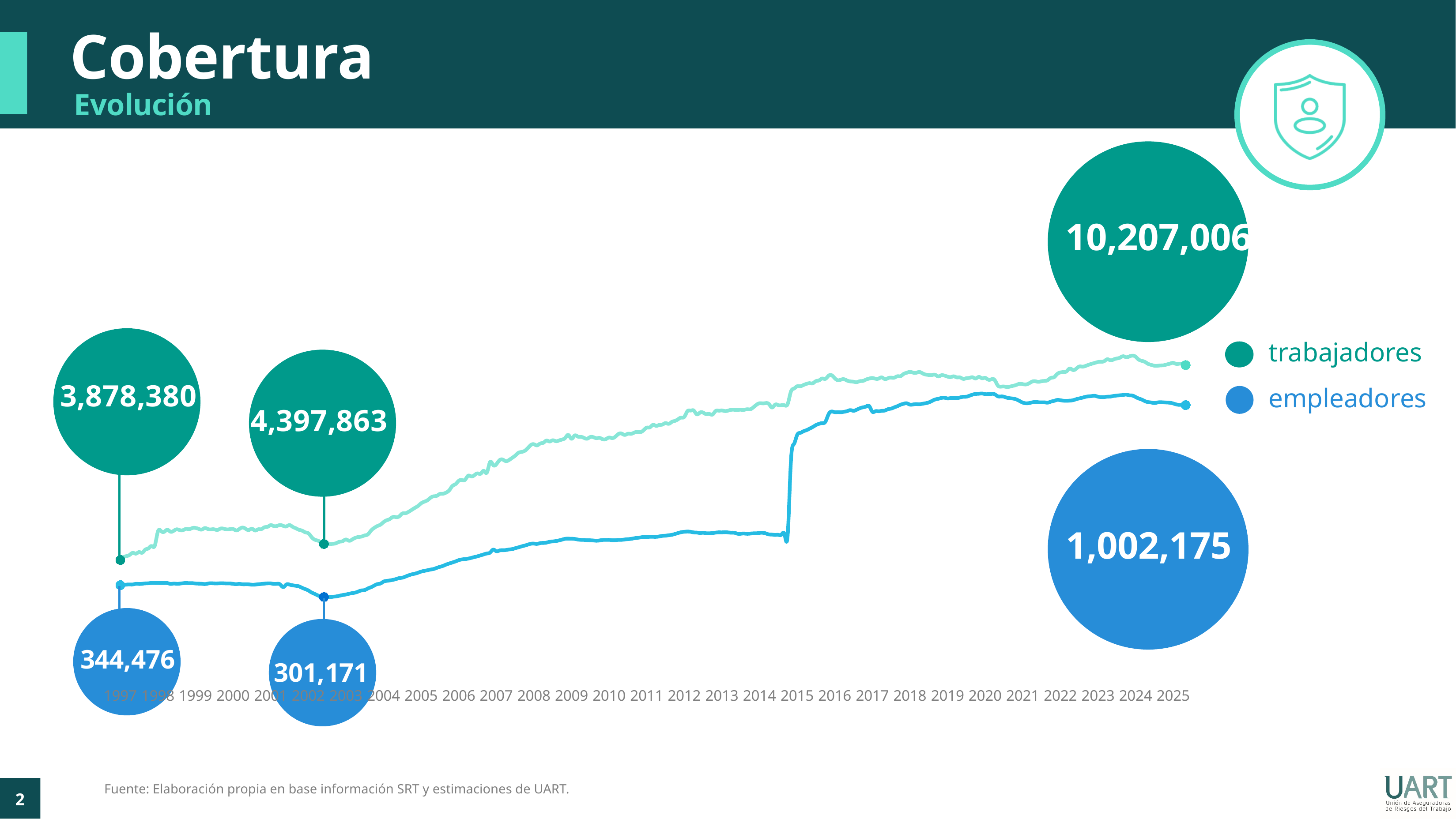
Does the trabajadores line generally rise or fall from 1997 to 2025? rise What is the value for empleadores in 2025? 1,002,175 What is the value for trabajadores in 2025? 10,207,006 What is the value for trabajadores in 1997? 3,878,380 How many series does the legend list? 2 What type of chart is shown on the slide? line chart What is the value for trabajadores in 2002? 4,397,863 What is the value for empleadores in 2002? 301,171 What is the difference between the empleadores value in 1997 and in 2002? 43,305 Which series has the higher value in 2025, trabajadores or empleadores? trabajadores What is the difference between the trabajadores value in 2025 and in 1997? 6,328,626 What is the value for empleadores in 1997? 344,476